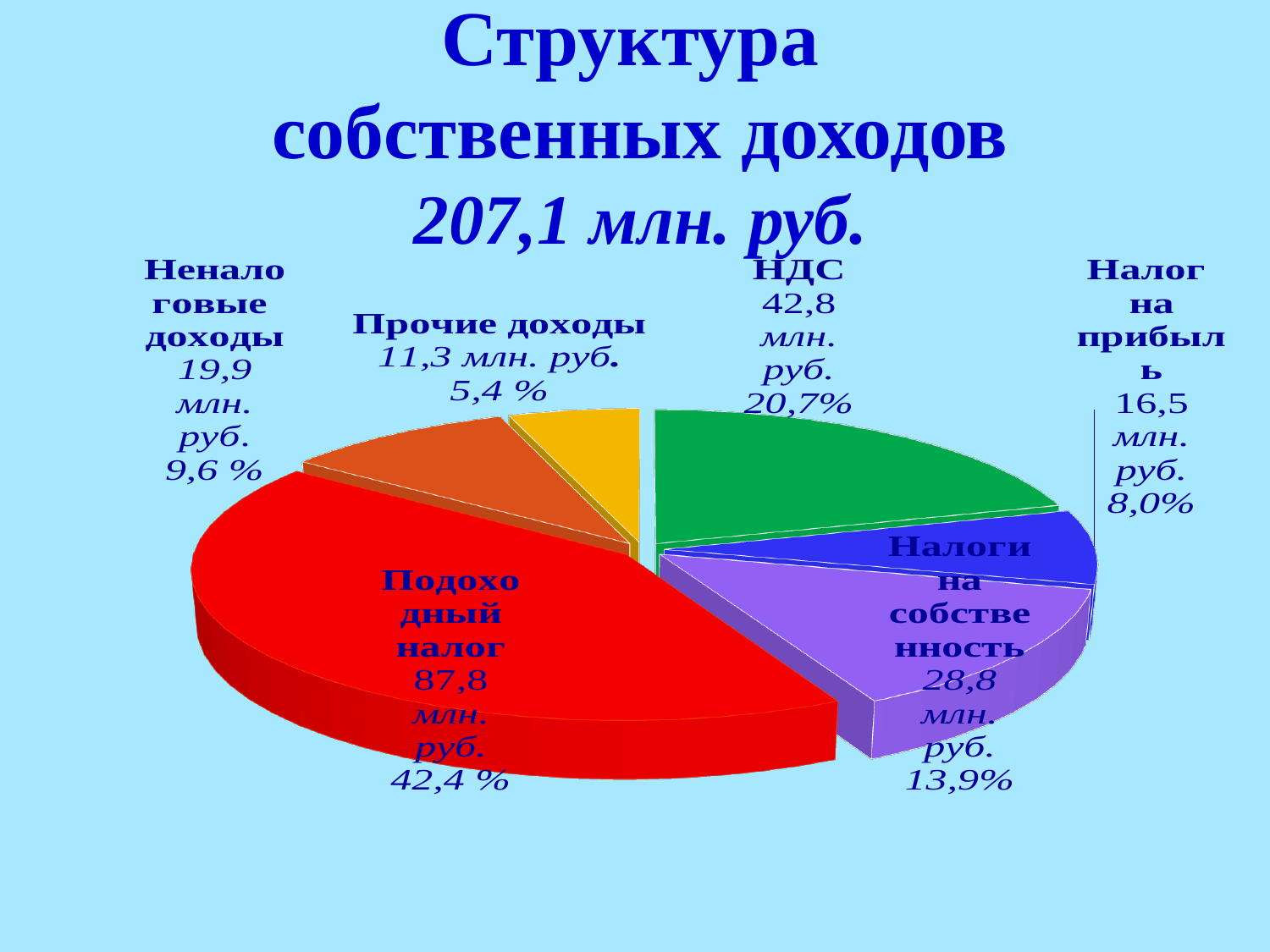
What total amount is stated in the chart title? 207,1 млн. руб. How many slices does the pie chart have? 6 What is the value for Подоходный налог in млн. руб.? 87,8 млн. руб. What is the difference in млн. руб. between НДС and Налоги на собственность? 14,0 млн. руб. What share of the pie does НДС represent? 20,7% Which is larger, Неналоговые доходы or Налог на прибыль? Неналоговые доходы Which category has the largest slice of the pie? Подоходный налог What colour is the slice for Подоходный налог? red What percentage share is shown for Прочие доходы? 5,4 % What is the value for Налоги на собственность in млн. руб.? 28,8 млн. руб. What kind of chart is shown on the slide? pie chart Which category has the smallest slice of the pie? Прочие доходы